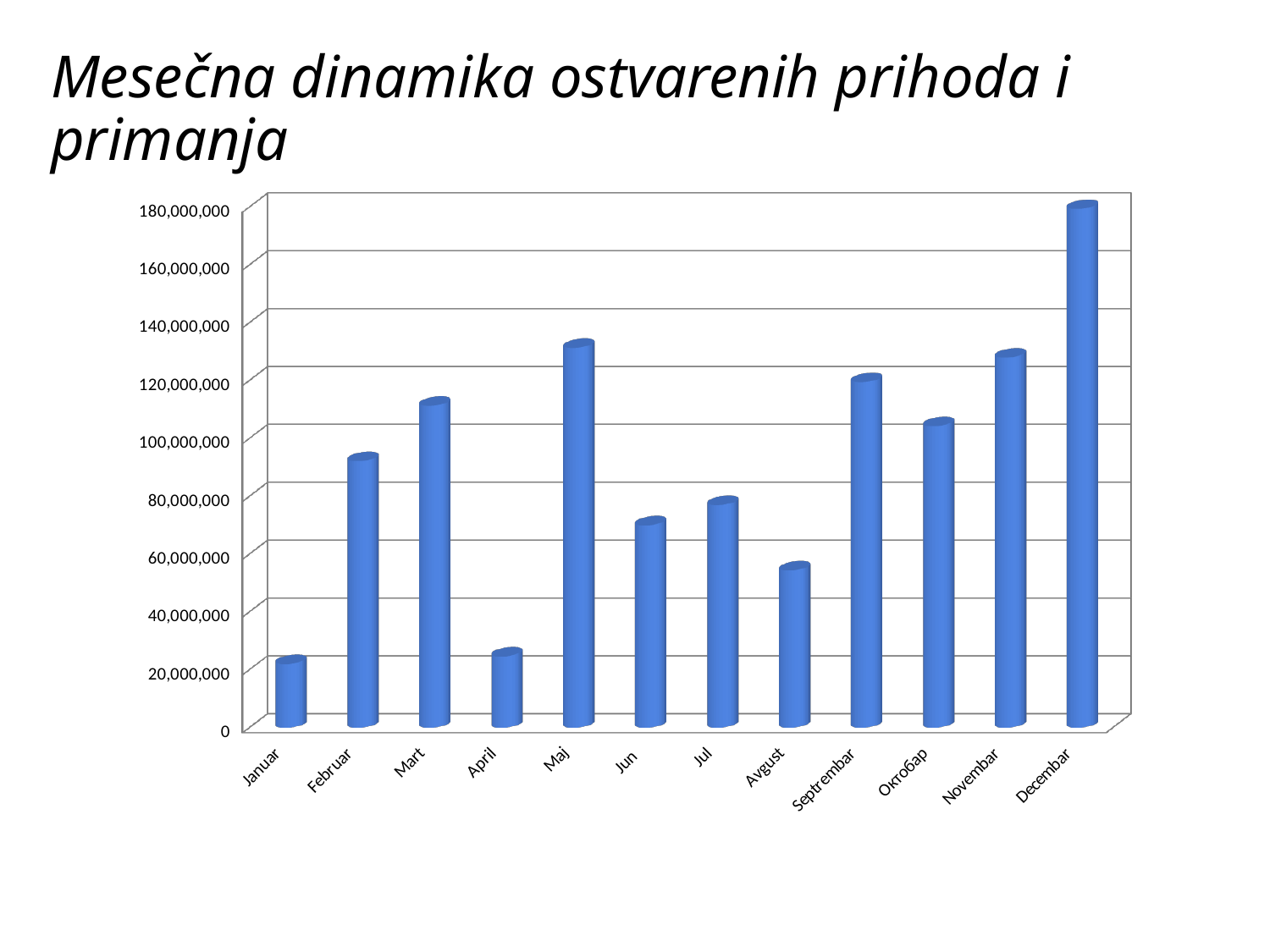
Is the value for Maj greater or less than 120,000,000? greater Is the value for Januar greater or less than 40,000,000? less Is the value for Decembar greater or less than 160,000,000? greater What kind of chart is shown on the slide? bar chart What is the title of the slide containing the chart? Mesečna dinamika ostvarenih prihoda i primanja Which is larger, the value for Septembar or the value for Oktobar? Septembar Which is larger, the value for Mart or the value for Februar? Mart Which month has the highest value in the chart? Decembar How many months are shown on the x axis of the chart? 12